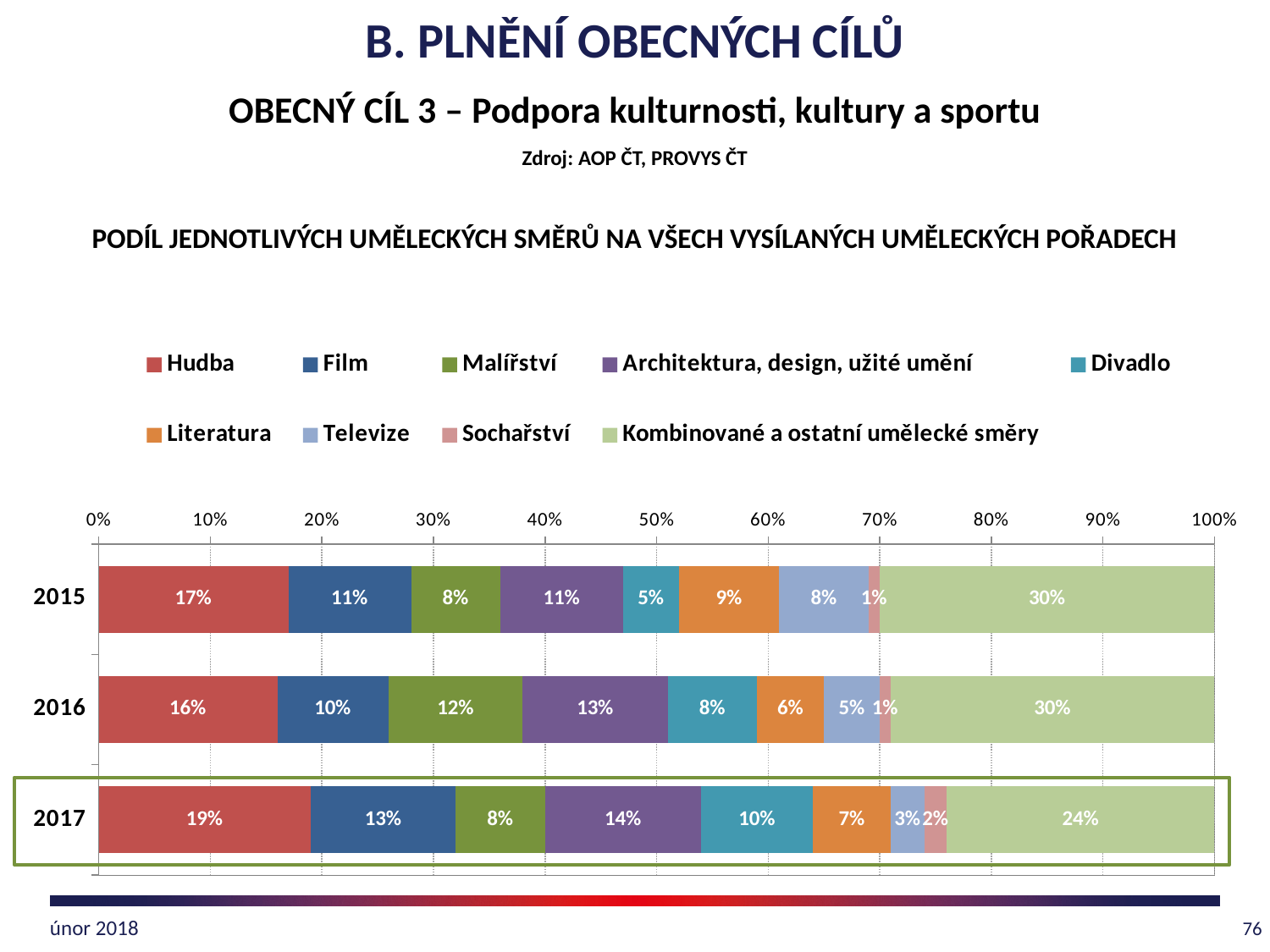
What is the value for Malířství in 2016? 12% What is the difference between the Hudba value in 2017 and the Hudba value in 2016? 3% Which series has the largest share in the 2015 bar? Kombinované a ostatní umělecké směry What is the value for Hudba in 2017? 19% Which series has the smallest share in the 2016 bar? Sochařství How many series does the legend list? 9 What is the value for Kombinované a ostatní umělecké směry in 2017? 24% How many years (bars) are shown in the chart? 3 What kind of chart is shown on the slide? Stacked bar chart Which is larger in 2017: the value for Film or the value for Divadlo? Film What is the value for Divadlo in 2015? 5% Does the value for Divadlo rise or fall from 2015 to 2017? Rise